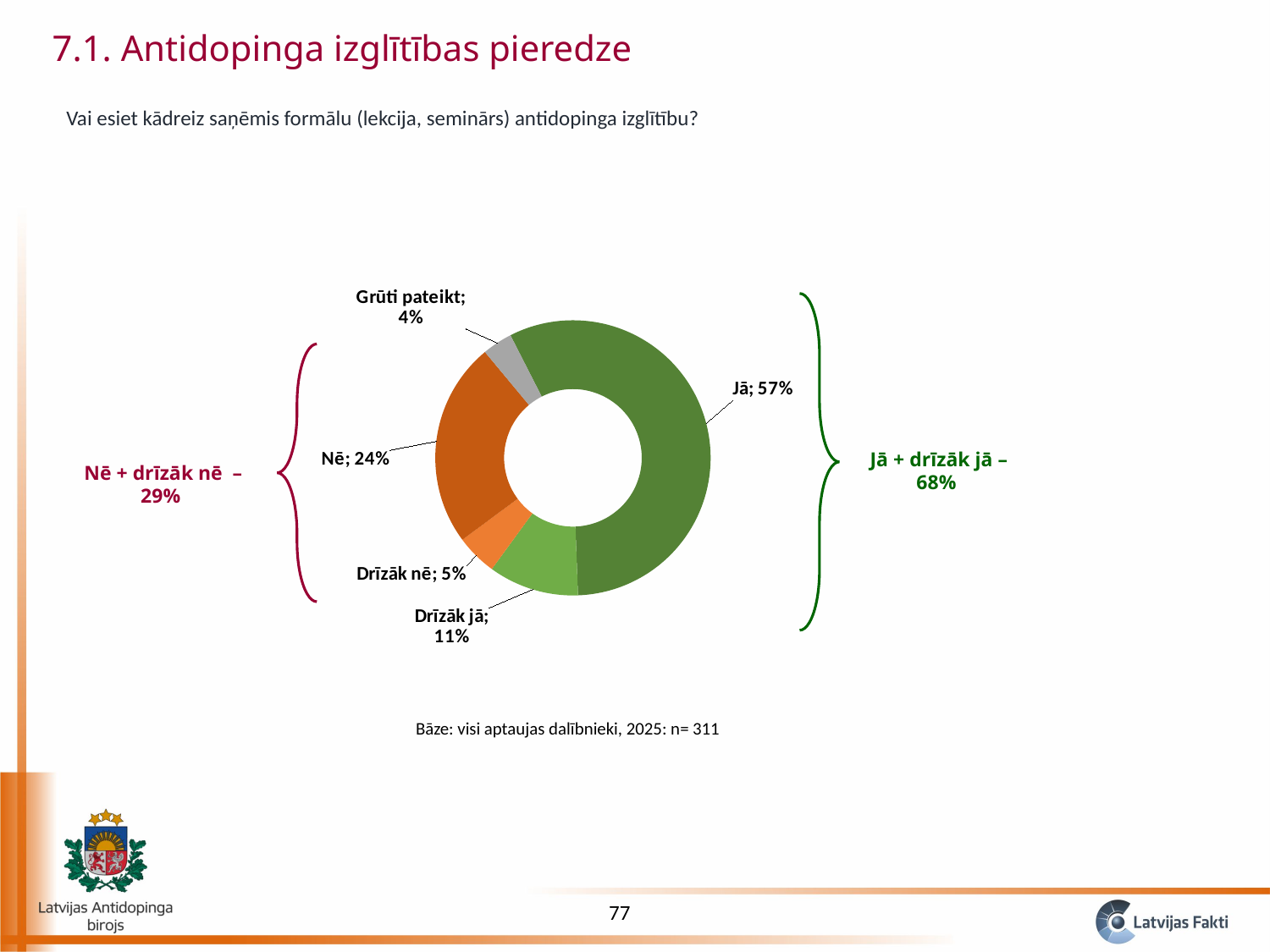
How many response categories are shown in the chart? 5 What kind of chart is shown on the slide? Pie chart (doughnut) What percentage of respondents answered "Grūti pateikt"? 4% Which response has the smallest share of the pie? Grūti pateikt What percentage of respondents answered "Drīzāk jā"? 11% What percentage of respondents answered "Drīzāk nē"? 5% What percentage of respondents answered "Jā"? 57% What is the difference in percentage points between "Jā" and "Nē"? 33 What percentage of respondents answered "Nē"? 24% Which is larger, the share for "Drīzāk jā" or the share for "Drīzāk nē"? Drīzāk jā What combined percentage is shown for "Jā + drīzāk jā"? 68% Which response has the largest share of the pie? Jā